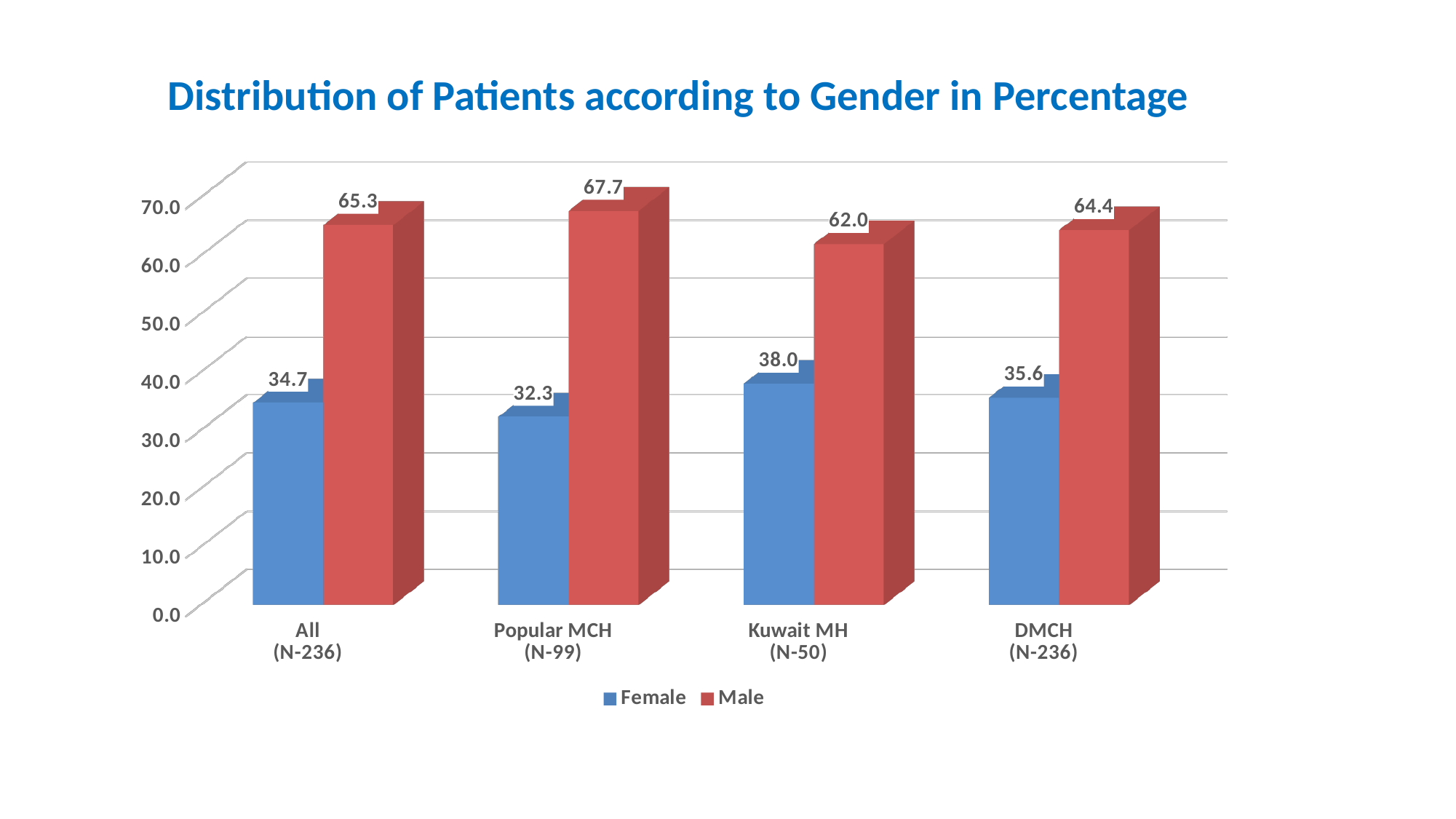
How many categories are shown on the x axis? 4 What is the Female value for All (N-236)? 34.7 What is the title of the chart? Distribution of Patients according to Gender in Percentage Is the Male value for Kuwait MH (N-50) greater or less than 50.0? greater Which category has the highest Male value? Popular MCH (N-99) What is the difference between the Male and Female values for DMCH (N-236)? 28.8 What is the Female value for Kuwait MH (N-50)? 38.0 How many series does the legend list? 2 What kind of chart is shown on the slide? bar chart What is the Male value for Popular MCH (N-99)? 67.7 Which is larger, the Female value for Kuwait MH (N-50) or the Female value for DMCH (N-236)? Kuwait MH (N-50) Which category has the lowest Female value? Popular MCH (N-99)